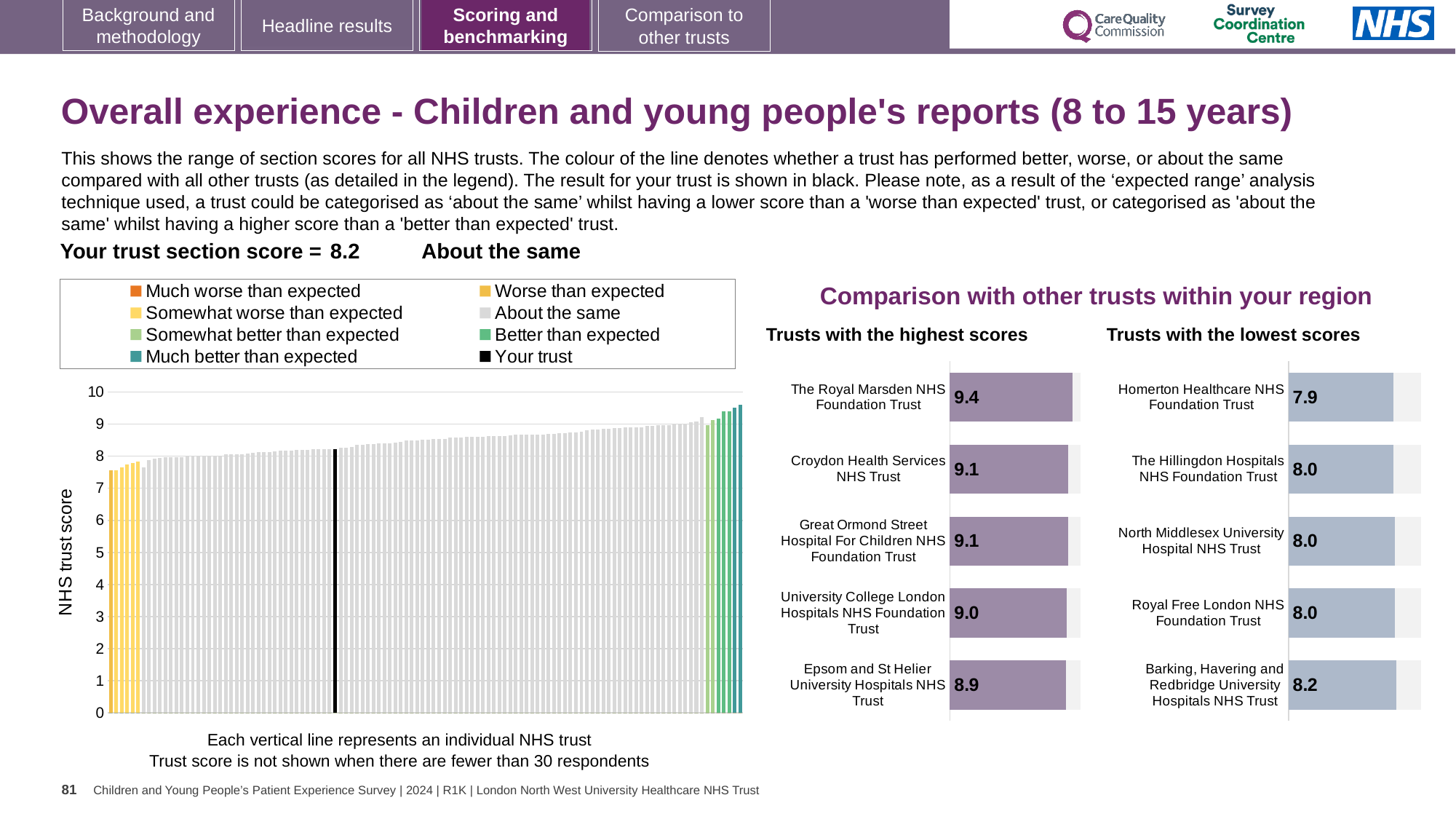
How many entries does the legend of the large chart on the left list? 8 In the 'Trusts with the highest scores' chart, what is the score for The Royal Marsden NHS Foundation Trust? 9.4 In the 'Trusts with the lowest scores' chart, what is the score for Homerton Healthcare NHS Foundation Trust? 7.9 In the large chart on the left, do the trust scores rise or fall from left to right? Rise In the 'Trusts with the lowest scores' chart, which trust has the highest score? Barking, Havering and Redbridge University Hospitals NHS Trust What kind of chart is the large chart on the left with the 'NHS trust score' axis? Bar chart In the 'Trusts with the highest scores' chart, which trust has the lowest score? Epsom and St Helier University Hospitals NHS Trust In the 'Trusts with the highest scores' chart, what is the difference between the scores of The Royal Marsden NHS Foundation Trust and Epsom and St Helier University Hospitals NHS Trust? 0.5 In the 'Trusts with the lowest scores' chart, what is the difference between the scores of Barking, Havering and Redbridge University Hospitals NHS Trust and Homerton Healthcare NHS Foundation Trust? 0.3 How many trusts are shown in the 'Trusts with the lowest scores' chart? 5 Which is larger: the score for Croydon Health Services NHS Trust in the highest scores chart or the score for Royal Free London NHS Foundation Trust in the lowest scores chart? Croydon Health Services NHS Trust In the large chart on the left, what colour is the bar for your trust? Black